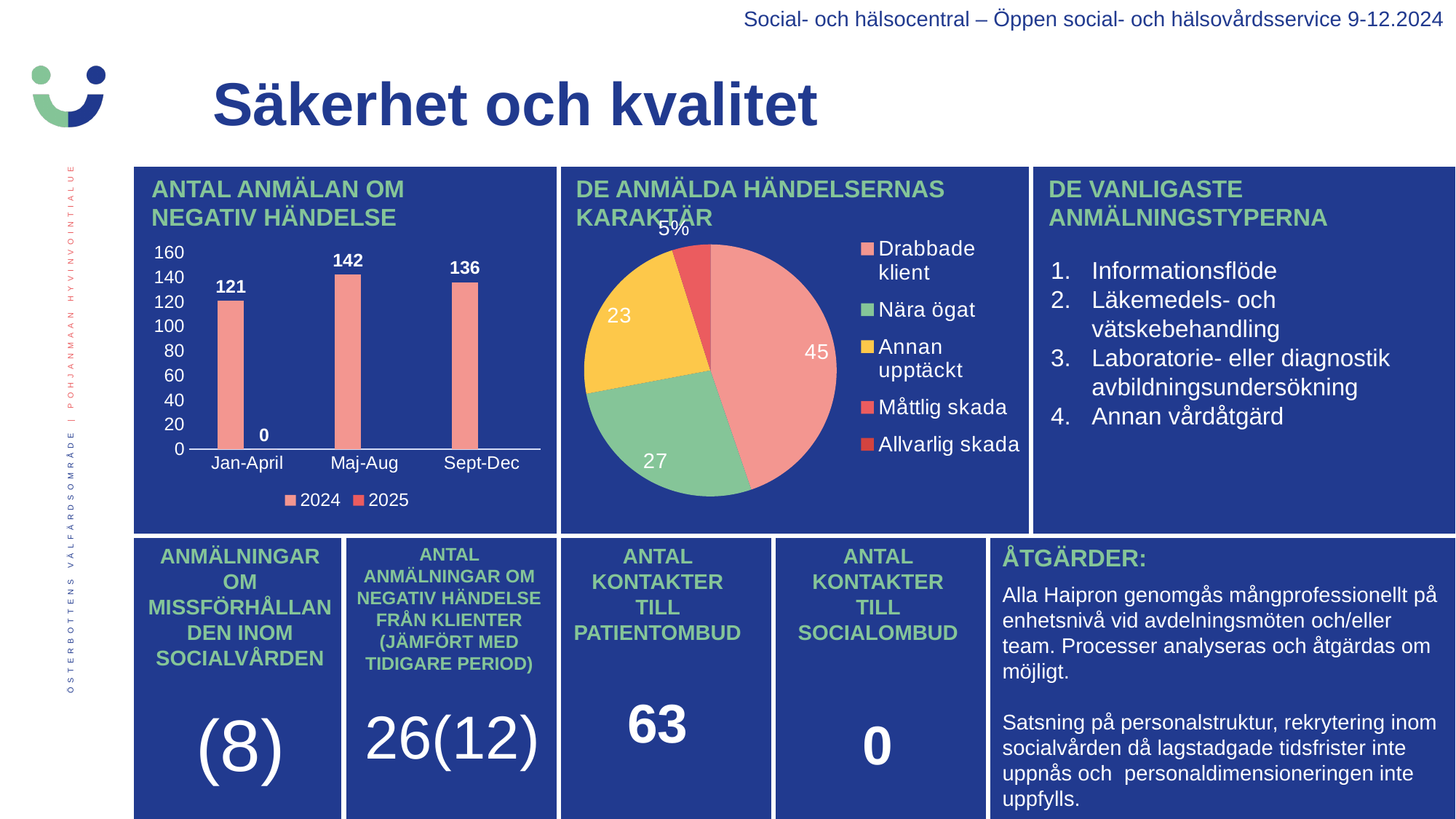
In the bar chart 'ANTAL ANMÄLAN OM NEGATIV HÄNDELSE', what is the 2025 value for Jan-April? 0 In the bar chart 'ANTAL ANMÄLAN OM NEGATIV HÄNDELSE', which period has the highest value? Maj-Aug In the pie chart 'DE ANMÄLDA HÄNDELSERNAS KARAKTÄR', which category has the largest slice? Drabbade klient In the bar chart 'ANTAL ANMÄLAN OM NEGATIV HÄNDELSE', how many periods are shown on the x axis? 3 In the bar chart 'ANTAL ANMÄLAN OM NEGATIV HÄNDELSE', what is the difference between the Maj-Aug and Jan-April 2024 values? 21 In the bar chart 'ANTAL ANMÄLAN OM NEGATIV HÄNDELSE', what is the 2024 value for Jan-April? 121 In the bar chart 'ANTAL ANMÄLAN OM NEGATIV HÄNDELSE', how many series does the legend list? 2 In the bar chart 'ANTAL ANMÄLAN OM NEGATIV HÄNDELSE', what is the value for Maj-Aug? 142 In the pie chart 'DE ANMÄLDA HÄNDELSERNAS KARAKTÄR', what value is shown for Drabbade klient? 45 In the pie chart 'DE ANMÄLDA HÄNDELSERNAS KARAKTÄR', how many categories does the legend list? 5 In the bar chart 'ANTAL ANMÄLAN OM NEGATIV HÄNDELSE', which is larger: the value for Sept-Dec or the 2024 value for Jan-April? Sept-Dec What kind of chart is 'ANTAL ANMÄLAN OM NEGATIV HÄNDELSE'? bar chart